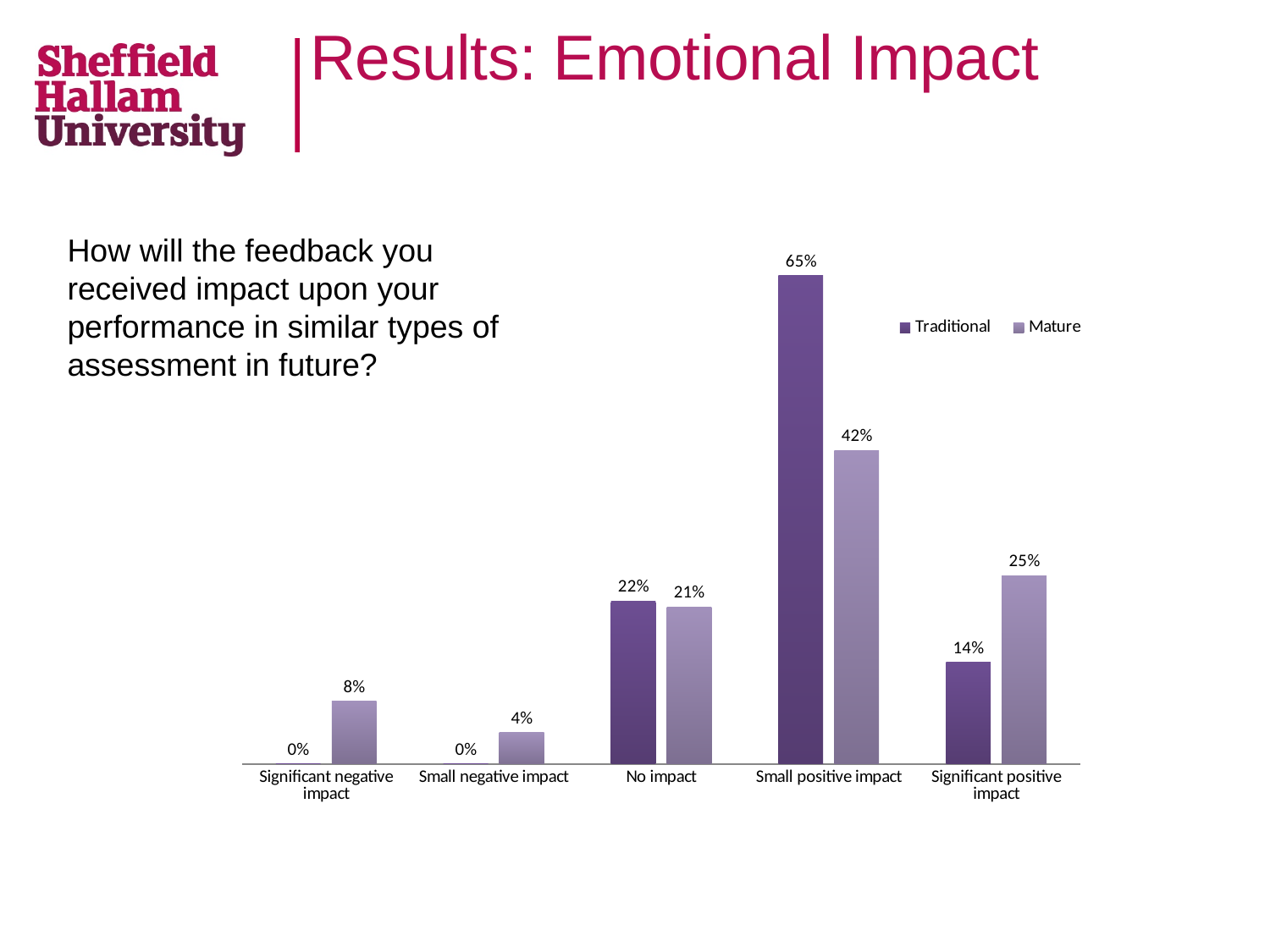
Which is larger for Significant positive impact, the Traditional value or the Mature value? Mature What is the Mature value for Significant negative impact? 8% What are the two series named in the legend? Traditional and Mature What is the Traditional value for No impact? 22% What is the difference between the Traditional and Mature values for Small positive impact? 23% What is the Traditional value for Small positive impact? 65% Which category has the highest Mature value? Small positive impact How many series does the legend list? 2 What is the Mature value for Significant positive impact? 25% What kind of chart is shown on the slide? Bar chart How many categories are shown on the x axis? 5 Which category has the lowest Mature value? Small negative impact